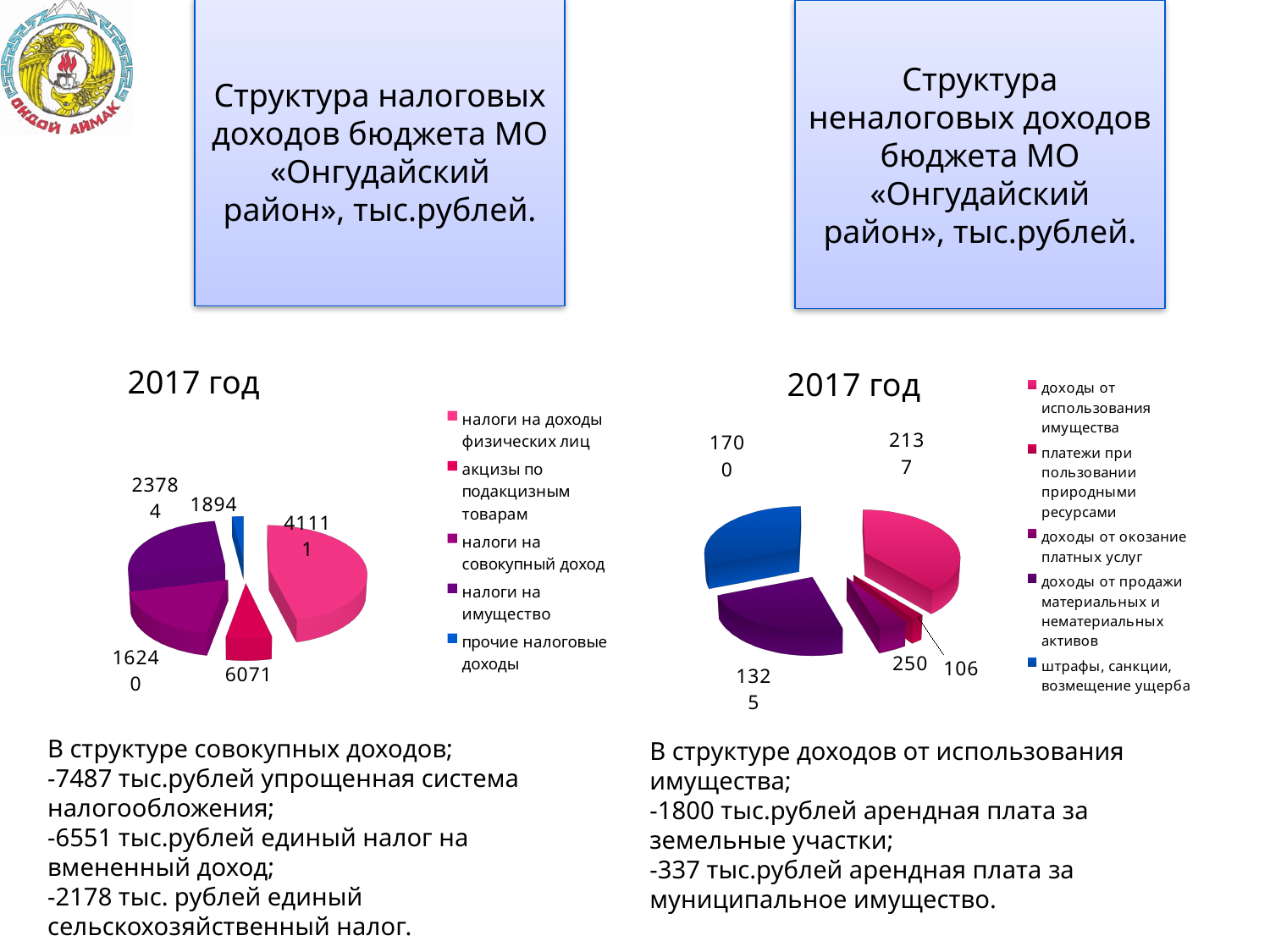
What kind of chart is the left chart titled "2017 год"? pie chart In the left pie chart, which category has the smallest slice? прочие налоговые доходы In the left pie chart, what is the difference between налоги на имущество (23784) and налоги на совокупный доход (16240)? 7544 In the right pie chart, which is larger: штрафы, санкции, возмещение ущерба or доходы от продажи материальных и нематериальных активов? штрафы, санкции, возмещение ущерба In the left pie chart, what is the value for налоги на доходы физических лиц? 41111 In the right pie chart, what is the value for штрафы, санкции, возмещение ущерба? 1700 In the left pie chart, what is the value for акцизы по подакцизным товарам? 6071 How many categories does the legend of the left pie chart list? 5 In the right pie chart, what is the difference between доходы от оказание платных услуг (250) and платежи при пользовании природными ресурсами (106)? 144 In the right pie chart, which category has the smallest slice? платежи при пользовании природными ресурсами In the right pie chart, which category has the largest slice? доходы от использования имущества In the left pie chart, which category has the largest slice? налоги на доходы физических лиц